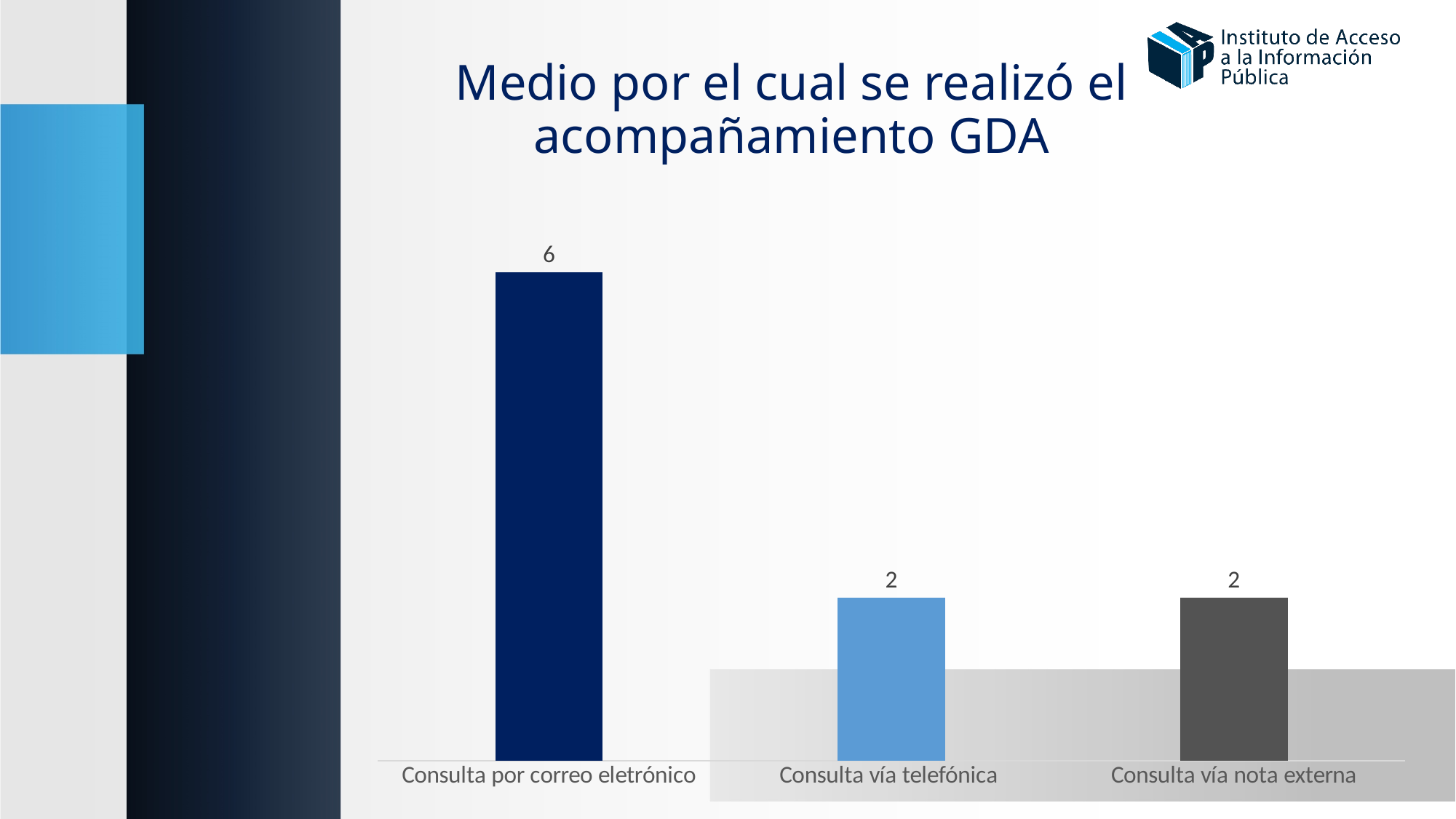
What is the value for Consulta por correo eletrónico? 6 What kind of chart is shown on the slide? bar chart What is the value for Consulta vía telefónica? 2 Which is larger, the value for Consulta por correo eletrónico or the value for Consulta vía nota externa? Consulta por correo eletrónico What is the difference between the values for Consulta por correo eletrónico and Consulta vía telefónica? 4 What colour is the bar for Consulta vía nota externa? dark grey How many categories are shown in the chart? 3 What is the title of the slide? Medio por el cual se realizó el acompañamiento GDA Which category has the highest value? Consulta por correo eletrónico What is the total of all three values in the chart? 10 What is the value for Consulta vía nota externa? 2